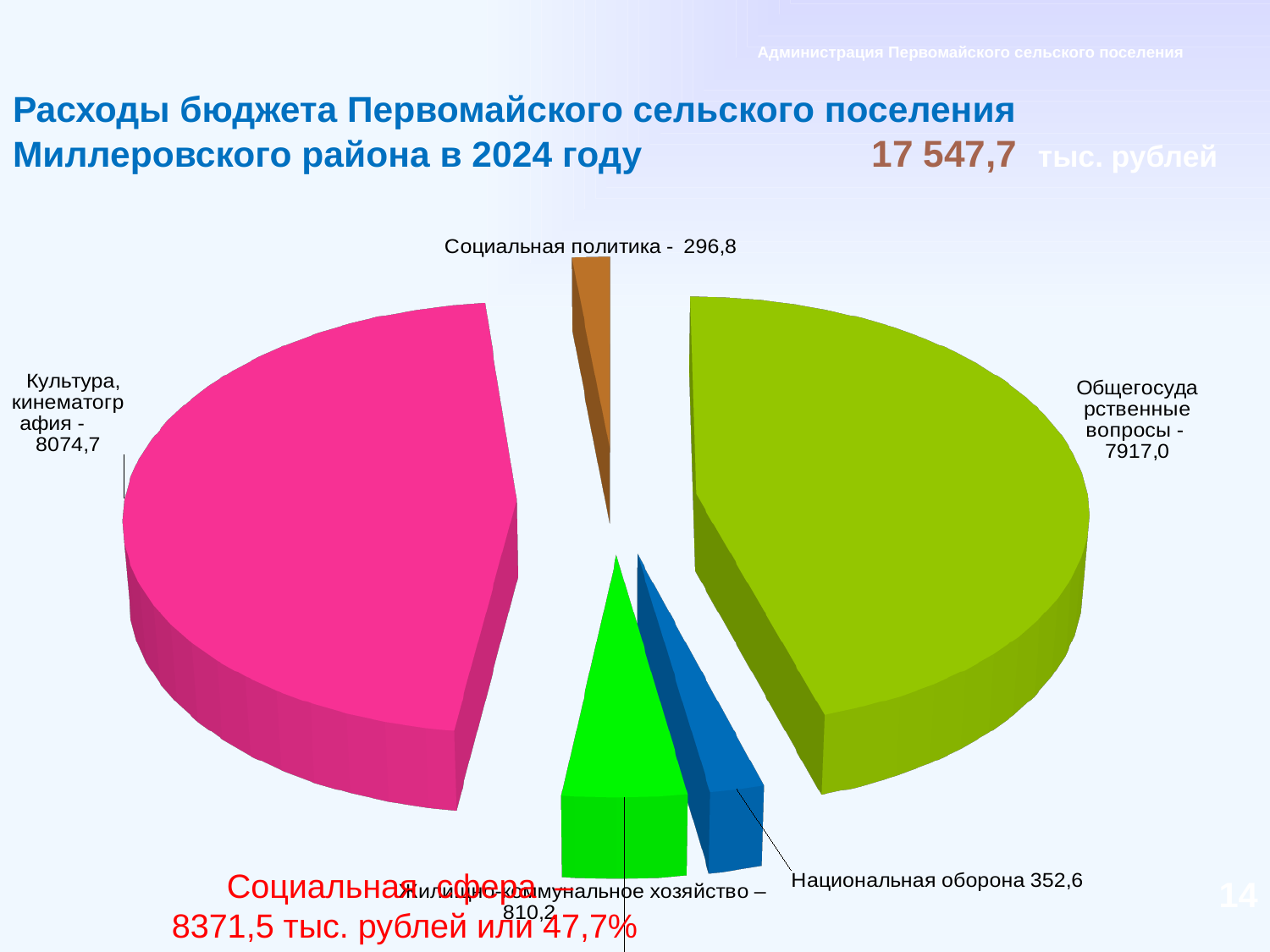
Which is larger: Национальная оборона or Социальная политика? Национальная оборона What is the value for Социальная политика? 296,8 What is the difference between the values for Культура, кинематография and Общегосударственные вопросы? 157,7 What is the value for Жилищно-коммунальное хозяйство? 810,2 What is the value for Культура, кинематография? 8074,7 How many slices does the pie chart have? 5 What is the value for Национальная оборона? 352,6 Which category has the smallest value in the pie chart? Социальная политика Which category has the largest value in the pie chart? Культура, кинематография What is the value for Общегосударственные вопросы? 7917,0 What kind of chart is shown on the slide? pie chart What total budget expenditure amount is printed in the slide title? 17 547,7 тыс. рублей